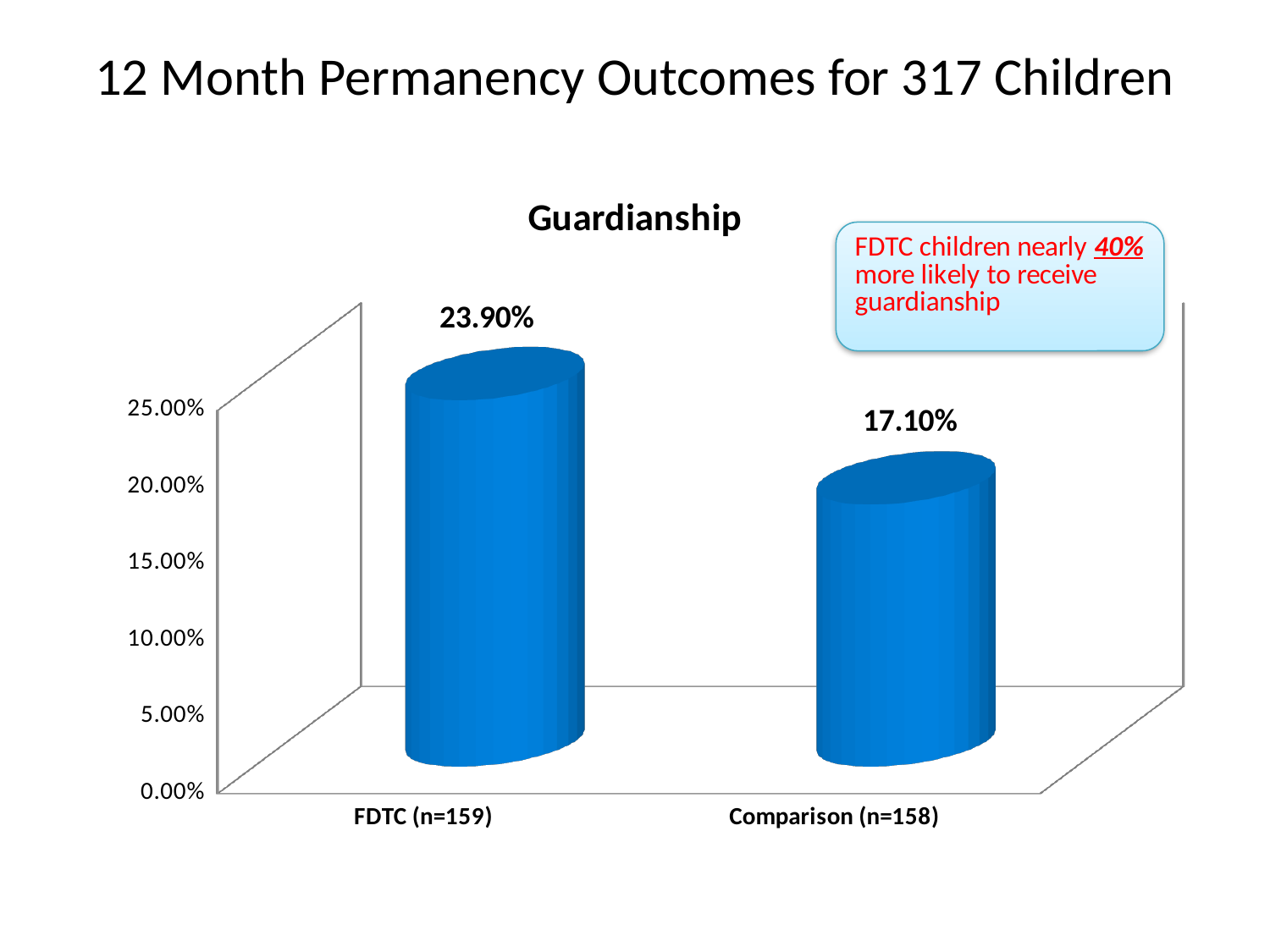
What is the guardianship rate for Comparison (n=158)? 17.10% What kind of chart is shown on the slide? bar chart What is the guardianship rate for FDTC (n=159)? 23.90% What is the difference in guardianship rate between FDTC (n=159) and Comparison (n=158)? 6.80% How many groups are plotted in the chart? 2 Which group has the lower guardianship rate? Comparison (n=158) According to the callout on the slide, how much more likely are FDTC children to receive guardianship? nearly 40% Is the value for FDTC (n=159) greater or less than 20.00%? greater Is the value for Comparison (n=158) greater or less than 20.00%? less What is the title of the chart? Guardianship Is the guardianship rate for FDTC (n=159) larger or smaller than that for Comparison (n=158)? larger Which group has the higher guardianship rate? FDTC (n=159)